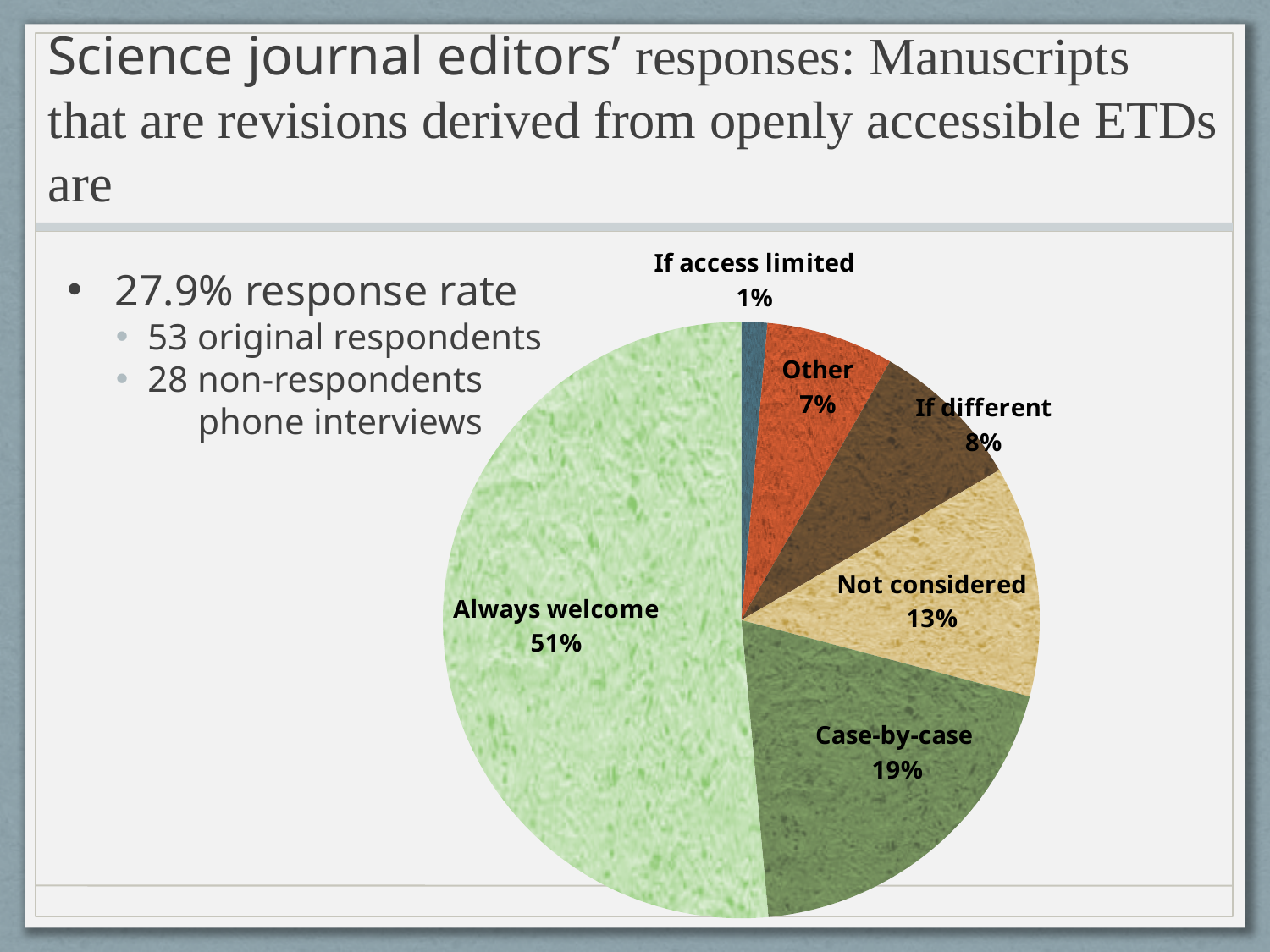
What share of responses is 'Not considered'? 13% Which category has the largest slice of the pie? Always welcome What share of responses is 'If access limited'? 1% What share of responses is 'Case-by-case'? 19% What share of responses is 'If different'? 8% What is the difference in percentage points between 'Always welcome' and 'Case-by-case'? 32 Which is larger, 'Other' or 'If different'? If different What is the combined share of 'Not considered' and 'Other'? 20% How many slices does the pie chart have? 6 What share of responses is 'Always welcome'? 51% Which category has the smallest slice of the pie? If access limited What kind of chart is shown on the slide? pie chart